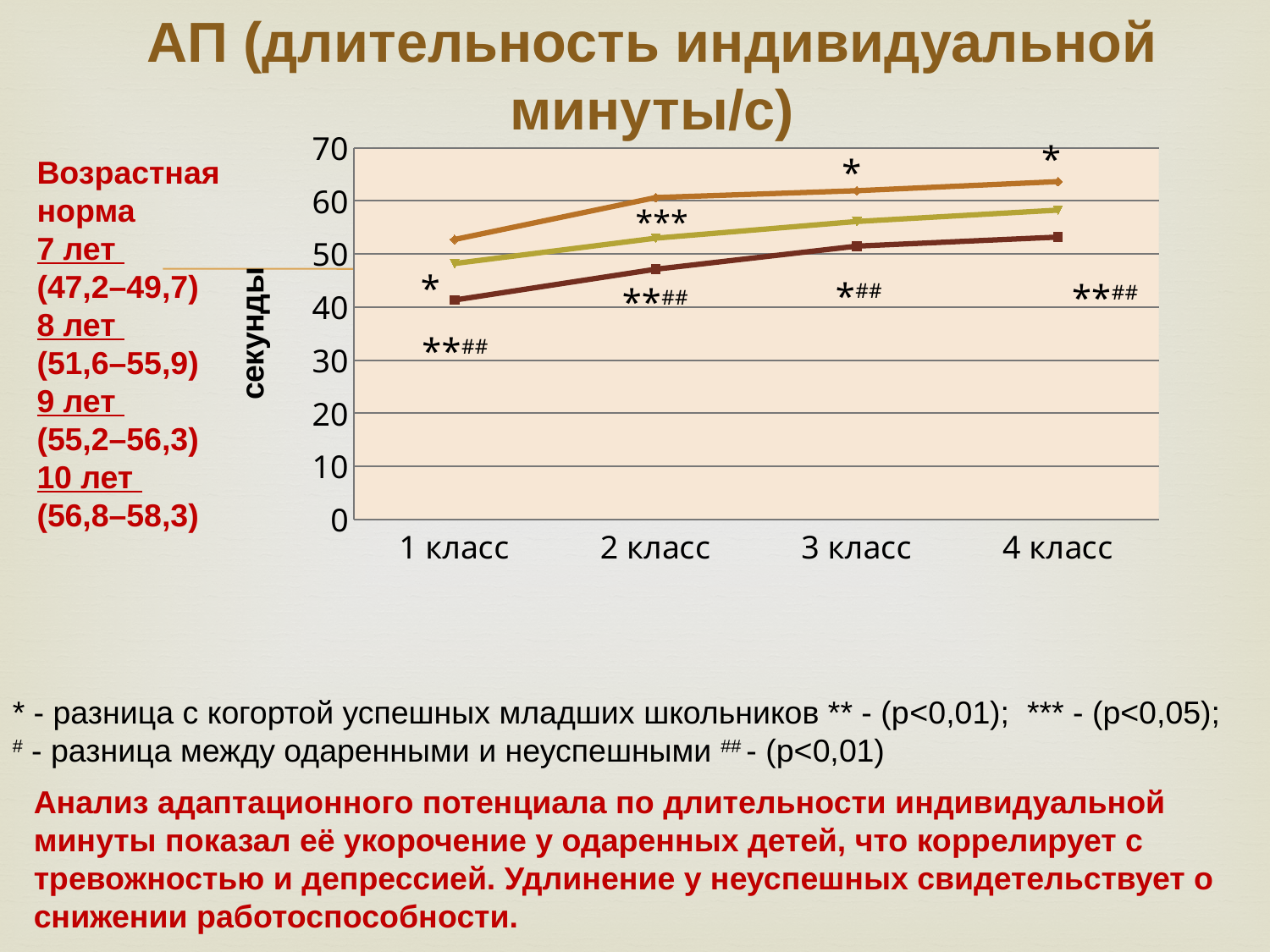
Do the values of the dark red line rise or fall from 1 класс to 4 класс? rise Which line has the highest value at 4 класс: the orange, the yellow-green or the dark red line? the orange line At 1 класс, which is larger: the value of the orange line or the value of the dark red line? the orange line How many categories are shown on the x axis of the chart? 4 Do the values of the orange line rise or fall from 1 класс to 4 класс? rise What is the label of the y axis of the chart? секунды How many lines are plotted on the chart? 3 Is the value of the orange line at 4 класс greater or less than 60? greater Is the value of the yellow-green line at 4 класс greater or less than 60? less What kind of chart is shown on the slide? line chart What is the title of the chart on the slide? АП (длительность индивидуальной минуты/с) Is the value of the dark red line at 1 класс greater or less than 50? less